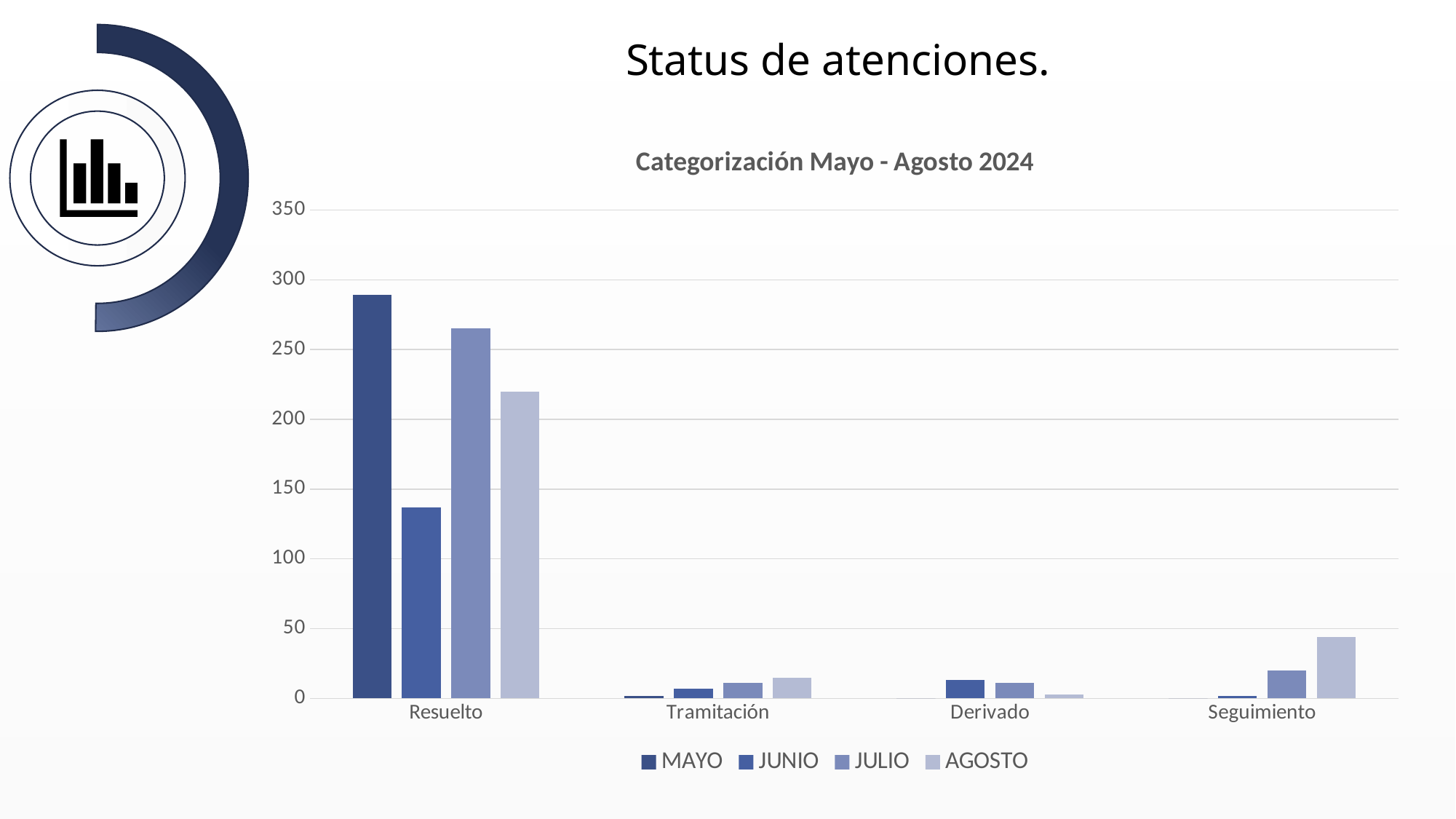
What kind of chart is shown on the slide? bar chart Which month has the highest value for Resuelto? MAYO How many series does the legend list? 4 Which month has the lowest value for Resuelto? JUNIO Is the value for AGOSTO in Seguimiento greater or less than 50? less Is the value for MAYO in Resuelto greater or less than 250? greater How many categories are shown on the x axis of the chart? 4 For Resuelto, which is larger, JULIO or AGOSTO? JULIO What is the title of the chart? Categorización Mayo - Agosto 2024 Is the value for AGOSTO in Resuelto greater or less than 200? greater Which month has the highest value for Seguimiento? AGOSTO